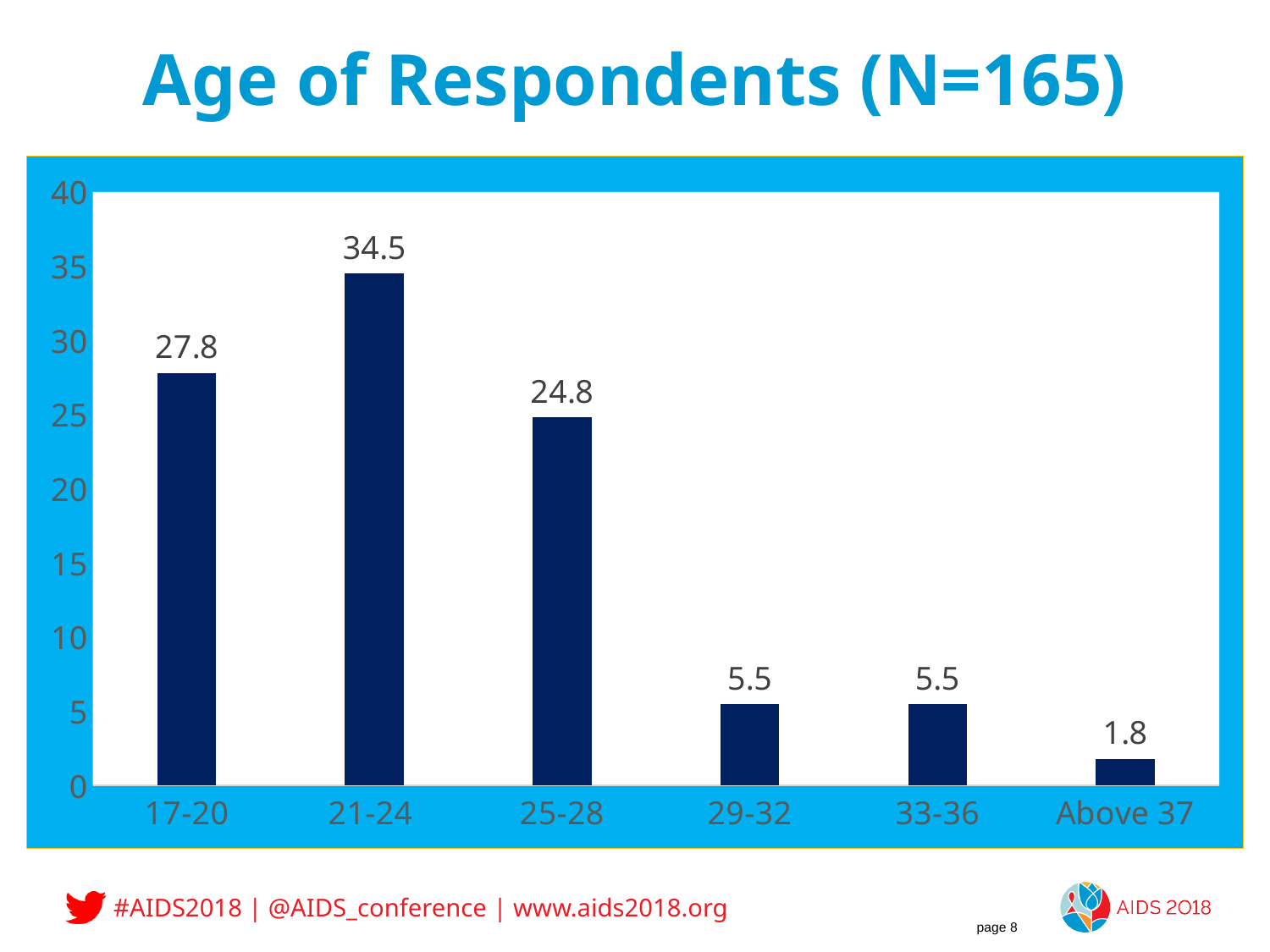
What is the title of the chart? Age of Respondents (N=165) Is the value for 25-28 greater or less than 20? greater What is the difference between the values for 21-24 and 25-28? 9.7 Which is larger, the value for 17-20 or the value for 25-28? 17-20 What is the value for the Above 37 age group? 1.8 What is the value for the 21-24 age group? 34.5 What is the value for the 17-20 age group? 27.8 How many age groups are shown on the x axis? 6 Which age group has the lowest value? Above 37 Which age group has the highest value? 21-24 What kind of chart is shown on the slide? bar chart Do the values rise or fall from 21-24 to Above 37? fall